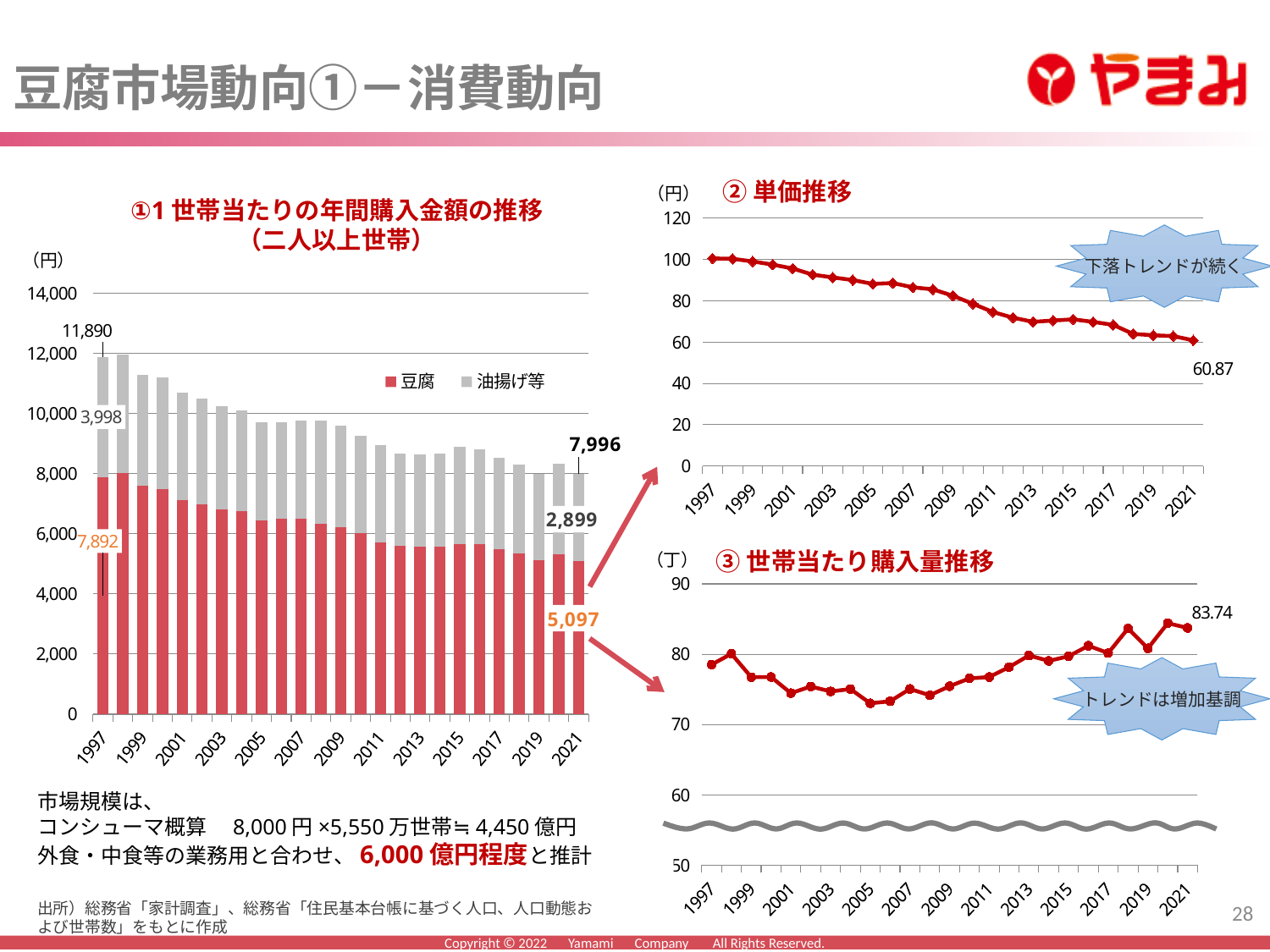
What kind of chart is ①1世帯当たりの年間購入金額の推移? Stacked bar chart In the chart ①1世帯当たりの年間購入金額の推移, what is the 油揚げ等 value for 2021? 2,899 In the chart ②単価推移, do the values rise or fall from 1997 to 2021? fall In the chart ②単価推移, what is the value for 2021? 60.87 In the chart ③世帯当たり購入量推移, what is the value for 2021? 83.74 In the chart ①1世帯当たりの年間購入金額の推移, what is the 豆腐 value for 1997? 7,892 In the chart ②単価推移, is the value for 1997 greater or less than 80? greater In the chart ①1世帯当たりの年間購入金額の推移, which is larger in 1997, 豆腐 or 油揚げ等? 豆腐 How many series does the legend of the chart ①1世帯当たりの年間購入金額の推移 list? 2 In the chart ①1世帯当たりの年間購入金額の推移, by how much did the 豆腐 value fall from 1997 to 2021? 2,795 In the chart ①1世帯当たりの年間購入金額の推移, what is the total annual purchase amount for 2021? 7,996 In the chart ①1世帯当たりの年間購入金額の推移, what is the difference between the 1997 total and the 2021 total? 3,894